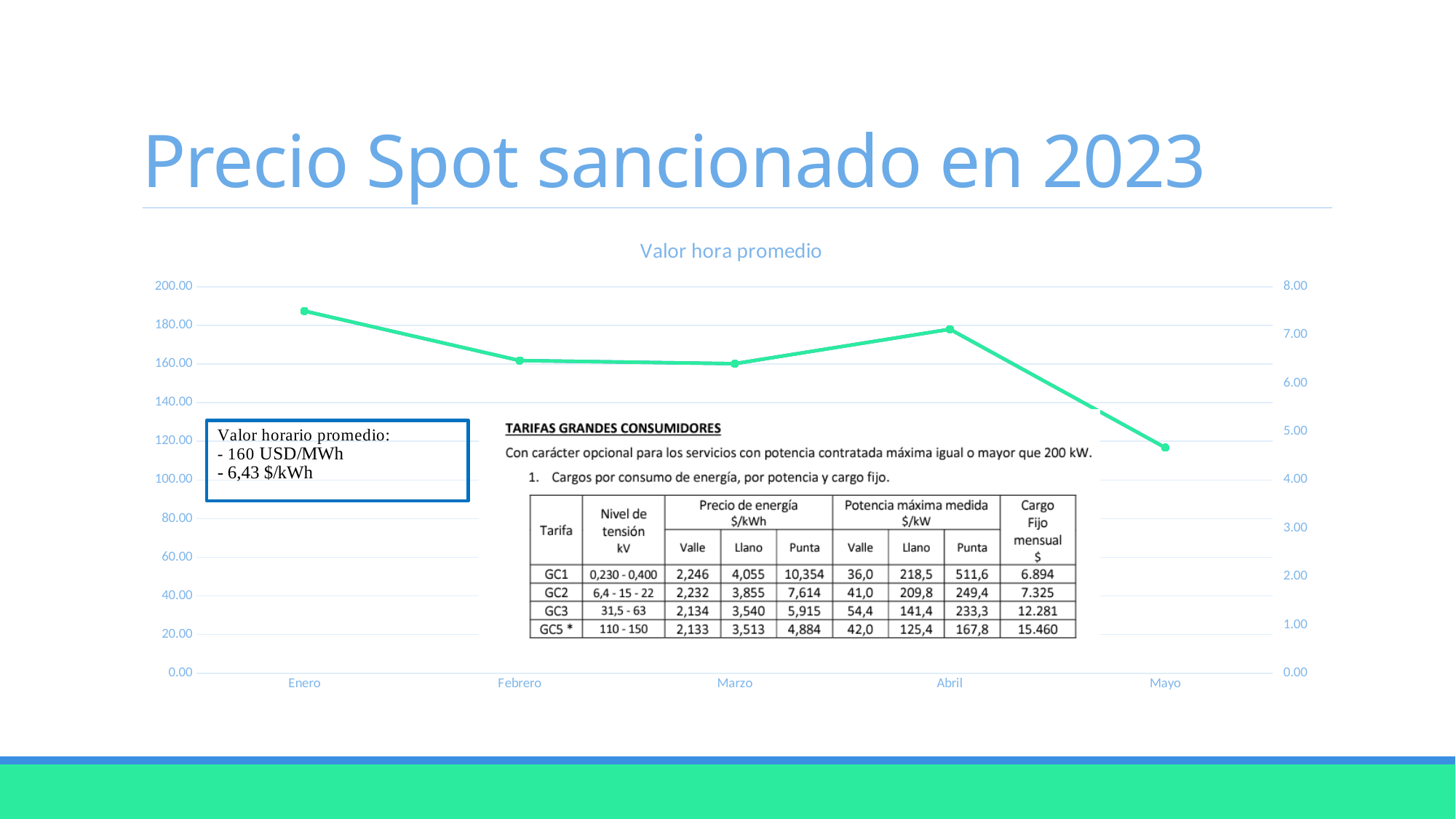
What is the title of the chart? Valor hora promedio Which is larger, the value for Abril or the value for Mayo? Abril Does the line rise or fall from Marzo to Abril? rise Which is larger, the value for Enero or the value for Abril? Enero Is the value for Enero greater or less than 180 on the left axis? greater What kind of chart is shown on the slide? line chart Does the line rise or fall from Abril to Mayo? fall Is the value for Febrero greater or less than 180 on the left axis? less Is the value for Mayo greater or less than 140 on the left axis? less Which month has the lowest value in the chart? Mayo How many months are plotted on the x axis of the chart? 5 Which month has the highest value in the chart? Enero